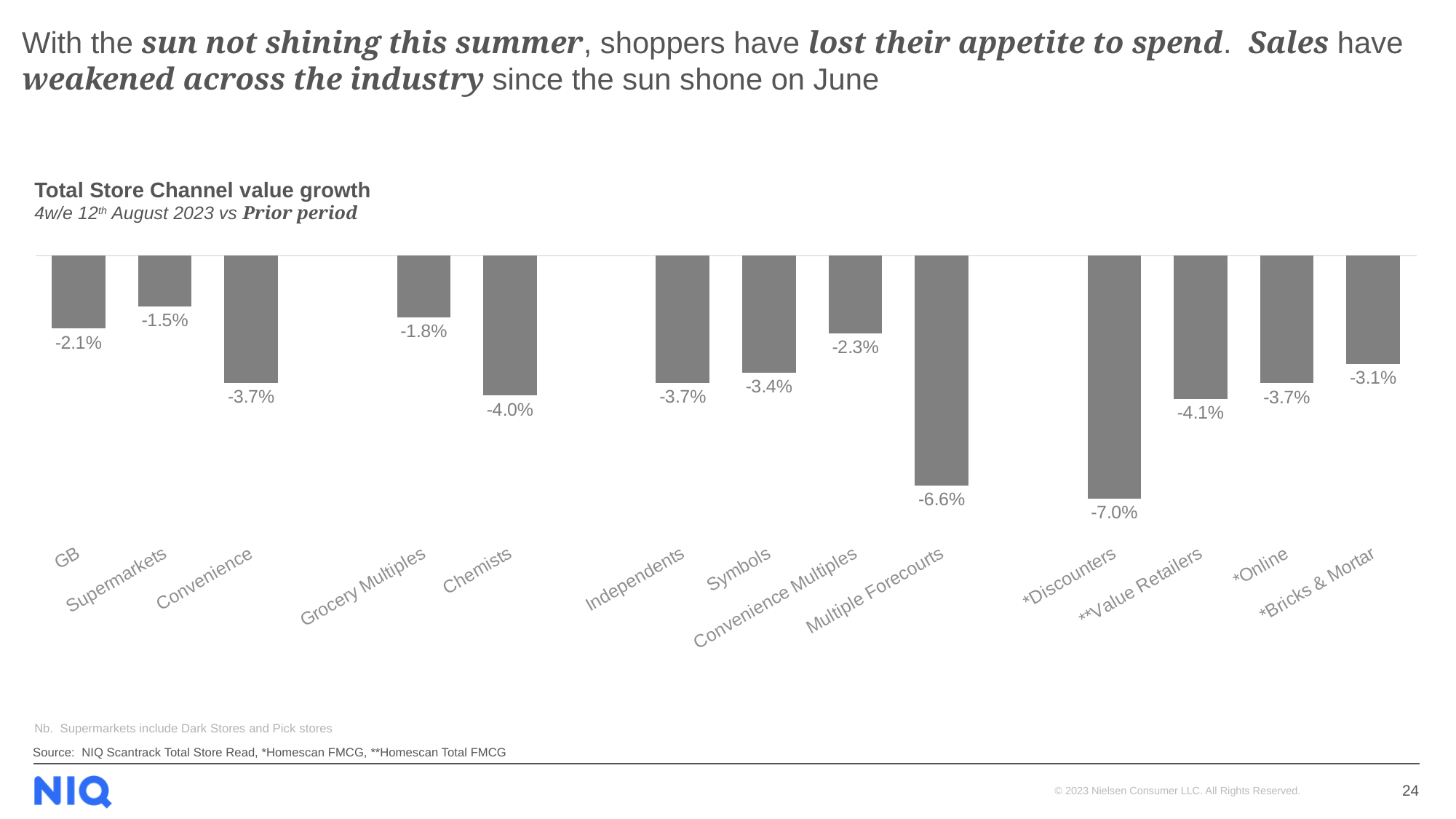
What is the value growth for Chemists? -4.0% What is the value growth for Supermarkets? -1.5% Which channel has the lowest value growth? *Discounters Which channel has the highest value growth? Supermarkets What period does the chart compare? 4w/e 12th August 2023 vs Prior period What is the difference between the value growth for Grocery Multiples and Convenience Multiples? 0.5 percentage points What is the title of the chart? Total Store Channel value growth What kind of chart is shown on the slide? Bar chart Which has the larger decline in value growth, Symbols or Value Retailers? **Value Retailers What is the value growth for GB? -2.1% How many channels are shown on the chart? 13 What is the value growth for Multiple Forecourts? -6.6%